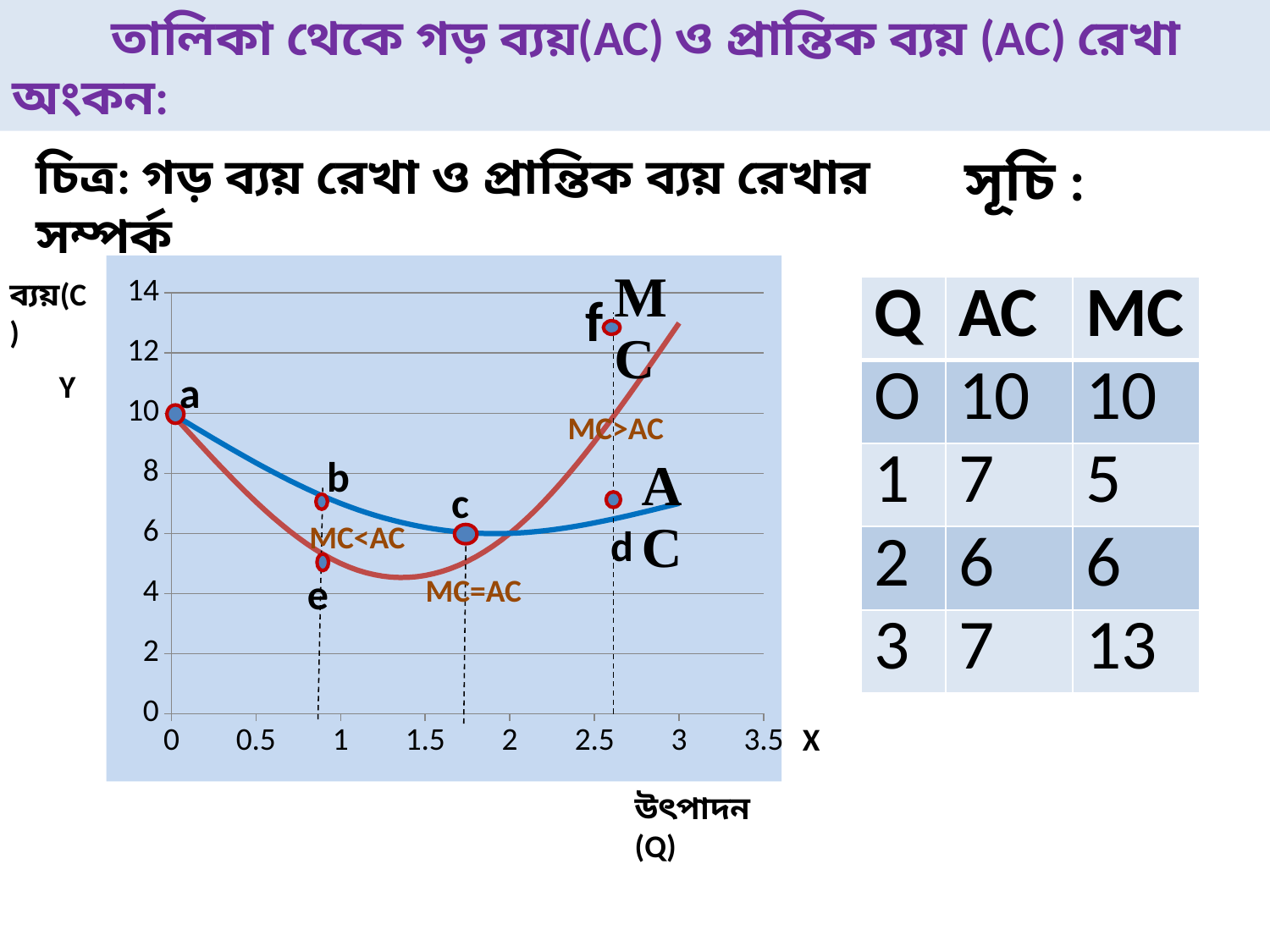
At which Q is MC highest? 3 What annotation is written near point c where the two curves meet? MC=AC At which Q is MC lowest? 1 What is the value of AC at Q = 2 according to the table? 6 By how much does MC exceed AC at Q = 3? 6 At Q = 1, which is larger, AC or MC? AC Is the value at point f on the MC curve greater or less than 12? greater Does the MC curve rise or fall between Q = 1 and Q = 3? rise How many curves are plotted on the chart? 2 What kind of chart is shown on the slide? line chart What is the value of AC at Q = 0 (point a)? 10 What is the value of MC at Q = 3 according to the table? 13